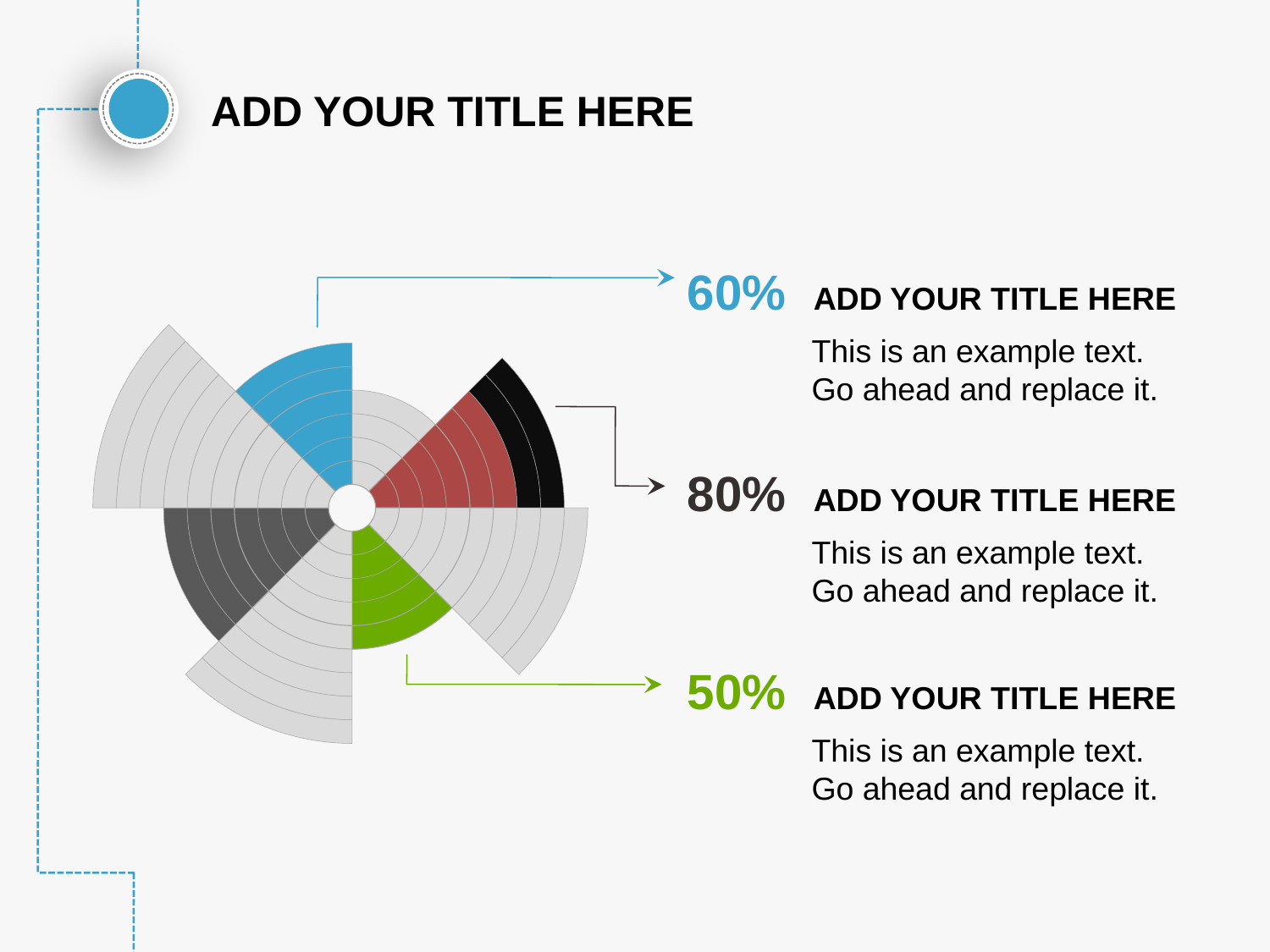
What is the difference between the black wedge's value and the blue wedge's value? 20 percentage points How many percentage values are labelled on the chart? 3 What kind of chart is shown on the slide? A doughnut chart (multi-ring) What percentage is shown for the black wedge of the radial chart? 80% What colour is the wedge that corresponds to the 50% label? Green Which of the three labelled percentages on the chart is the highest? 80% What percentage is shown for the blue wedge of the radial chart? 60% Which of the three labelled percentages on the chart is the lowest? 50% Which wedge has the larger value, the blue one or the green one? The blue one (60%) What is the difference between the highest labelled percentage (80%) and the lowest (50%)? 30 percentage points What percentage is shown for the green wedge of the radial chart? 50% What colour is the wedge that corresponds to the 60% label? Blue